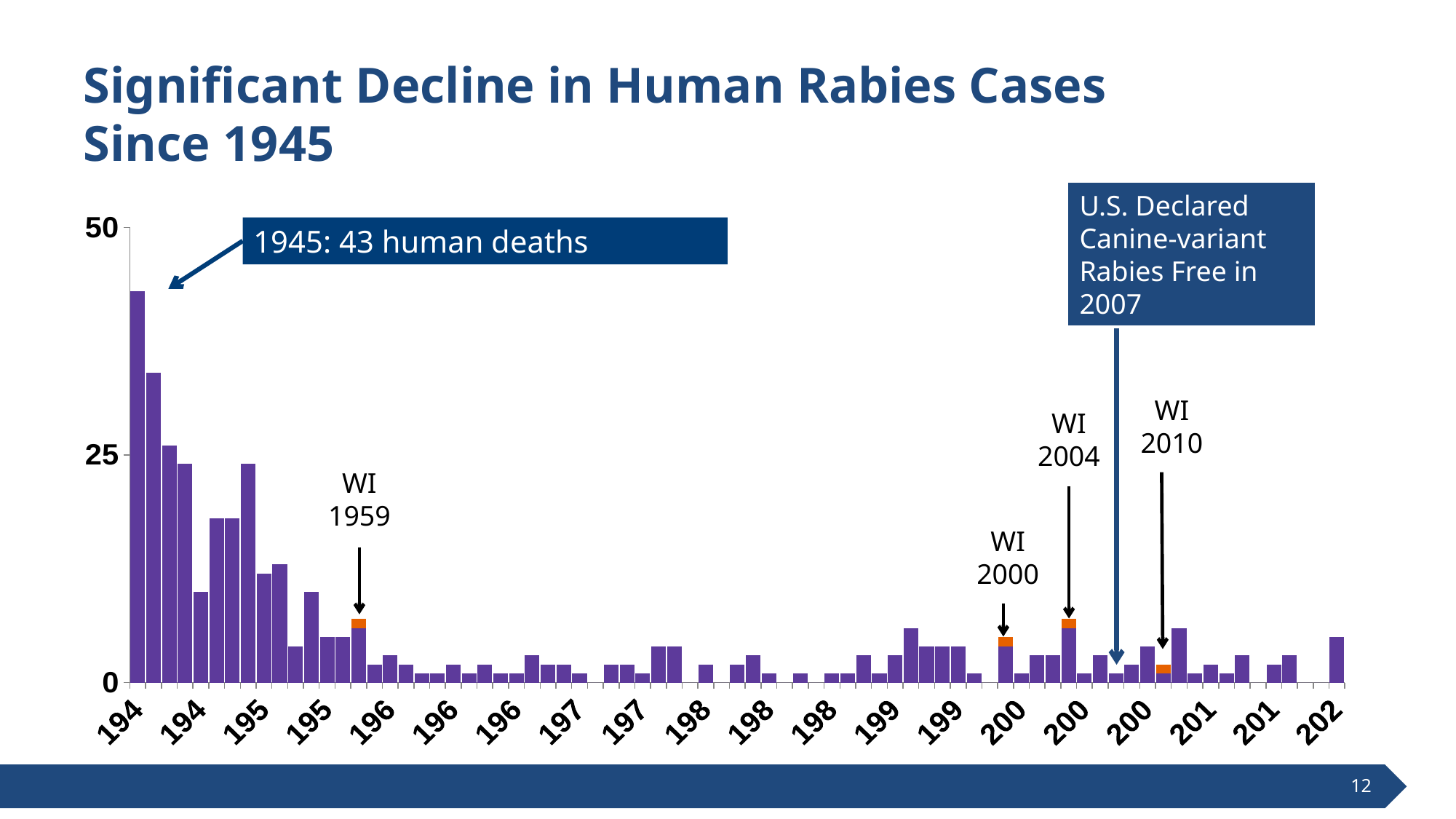
What is the highest tick value shown on the y axis? 50 What is the title of the slide containing the chart? Significant Decline in Human Rabies Cases Since 1945 Is the value for the bar marked WI 1959 greater or less than 25? less Is the value for 1945 greater or less than 25? greater In what year does the text box say the U.S. was declared canine-variant rabies free? 2007 How many human rabies deaths does the annotation give for 1945? 43 What kind of chart is shown on the slide? bar chart Overall, do the bar values rise or fall from left to right along the x axis? fall Which year has the tallest bar in the chart? 1945 Which is larger, the value for 1945 or the value for the bar marked WI 2004? 1945 How many bars are annotated with a 'WI' label? 4